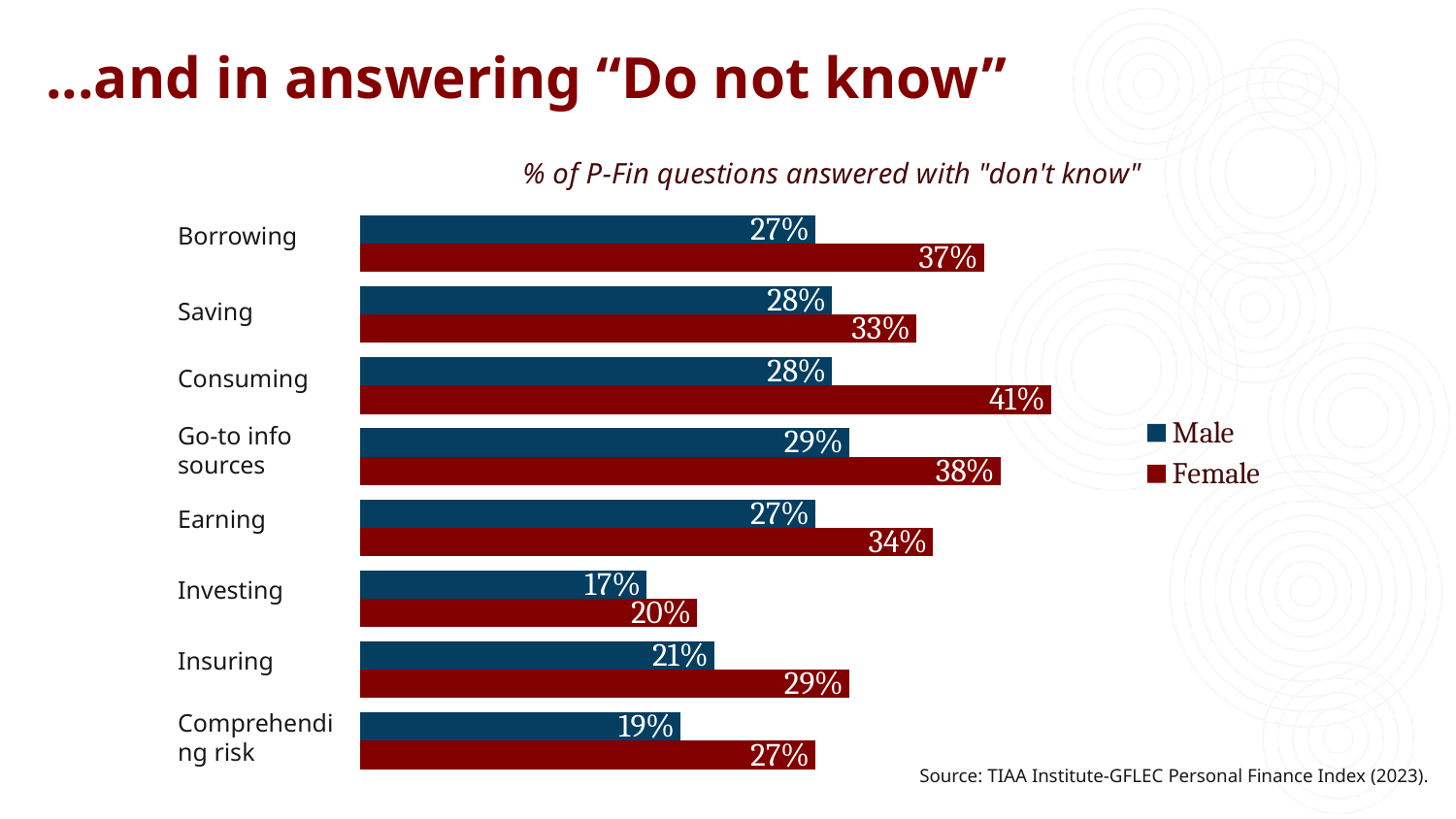
How many categories are shown on the chart? 8 What is the Male value for Investing? 17% What is the Female value for Consuming? 41% What percentage of Borrowing questions did females answer with "don't know"? 37% Which is larger, the Male value for Go-to info sources or the Male value for Insuring? Go-to info sources What is the title of the chart? % of P-Fin questions answered with "don't know" What kind of chart is shown on the slide? Bar chart Which category has the lowest Male value? Investing Which category has the highest Female value? Consuming What is the difference between the Female and Male values for Investing? 3% What is the difference between the Female and Male values for Consuming? 13% How many series does the legend list? 2